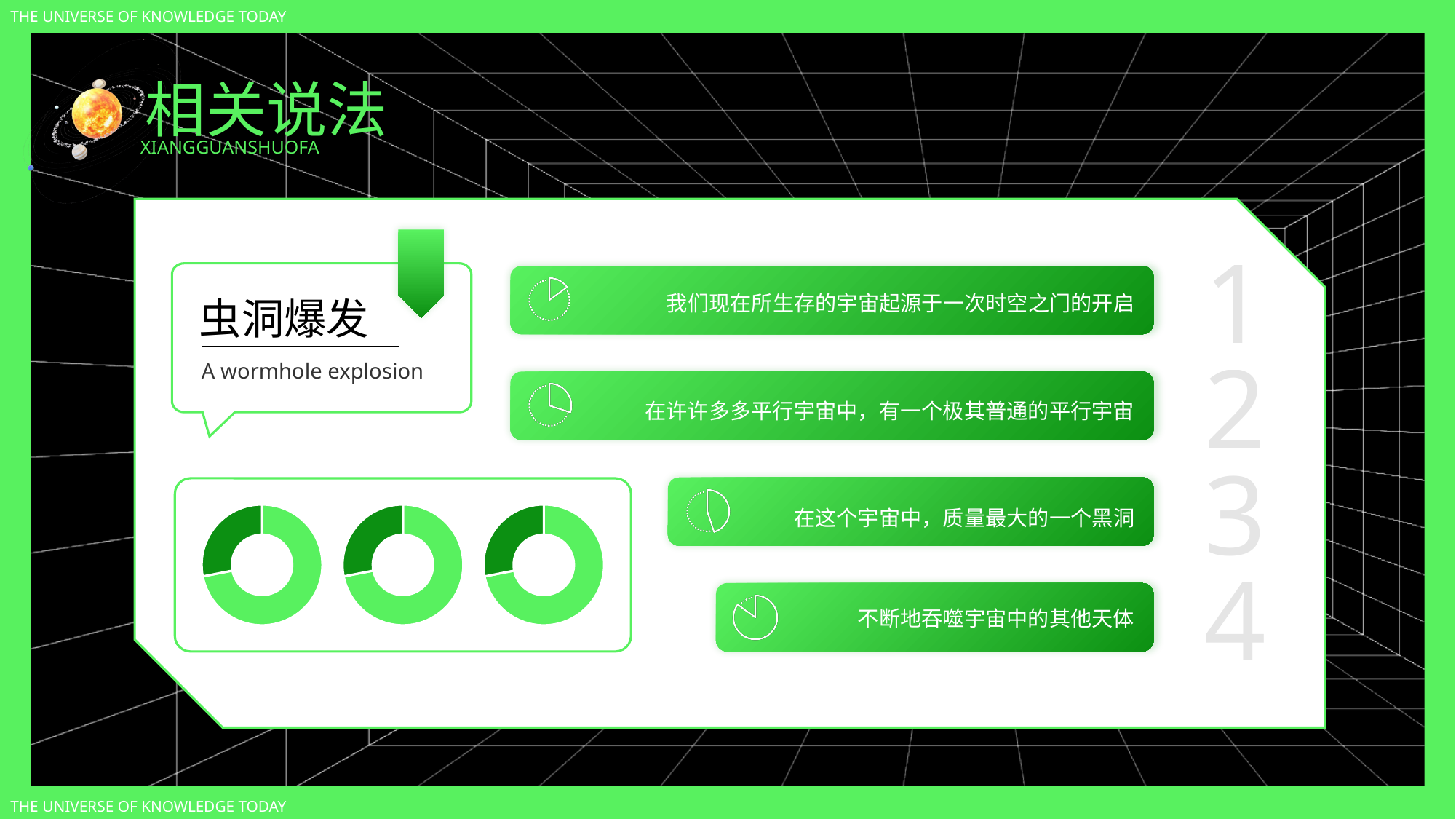
In the middle donut chart, which slice is larger, the dark green one or the light green one? The light green one What kind of chart is shown in the white panel at the bottom left of the slide? Donut chart Do the donut charts on the slide show a legend? No In the rightmost donut chart, which slice is larger, the dark green one or the light green one? The light green one How many donut charts are shown on the slide? 3 How many slices does the rightmost donut chart have? 2 Which of the three donut charts has the smallest dark green slice? None; all three dark green slices are the same size How many slices does the middle donut chart have? 2 In the leftmost donut chart, which slice is larger, the dark green one or the light green one? The light green one What two colours are used for the slices in the donut charts? Dark green and light green